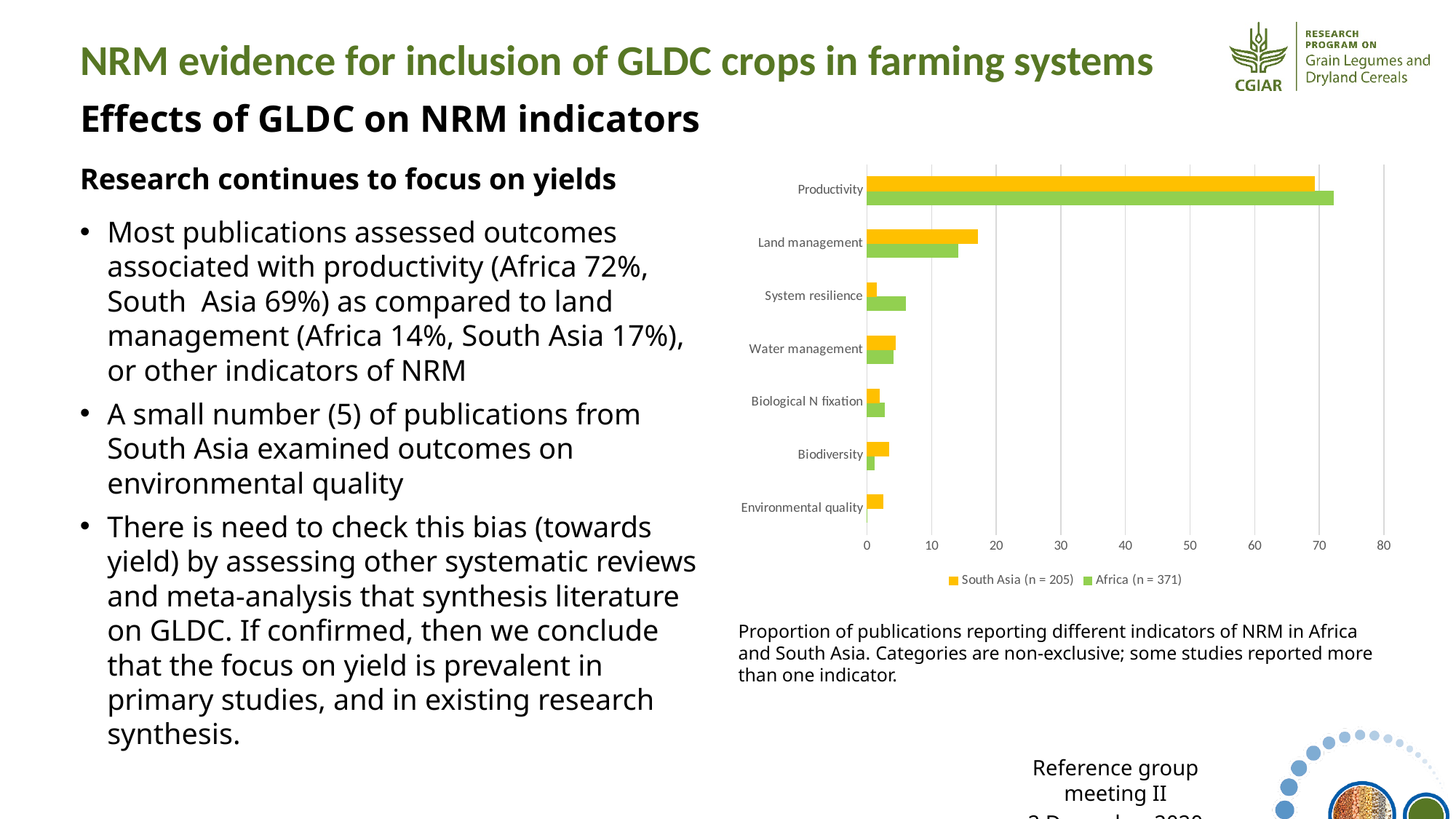
For Land management, which series has the larger value, South Asia or Africa? South Asia Is the South Asia value for Productivity greater or less than 60? greater How many NRM indicator categories are plotted on the chart? 7 What kind of chart is shown on the slide? Bar chart What sample size (n) does the legend give for the Africa series? n = 371 For Productivity, which series has the larger value, South Asia or Africa? Africa Is the Africa value for Productivity greater or less than 70? greater Is the Africa value for System resilience greater or less than 10? less How many series does the chart legend list? 2 Which category has the highest value for the South Asia series? Productivity Which category has the highest value for the Africa series? Productivity For System resilience, which series has the larger value, South Asia or Africa? Africa